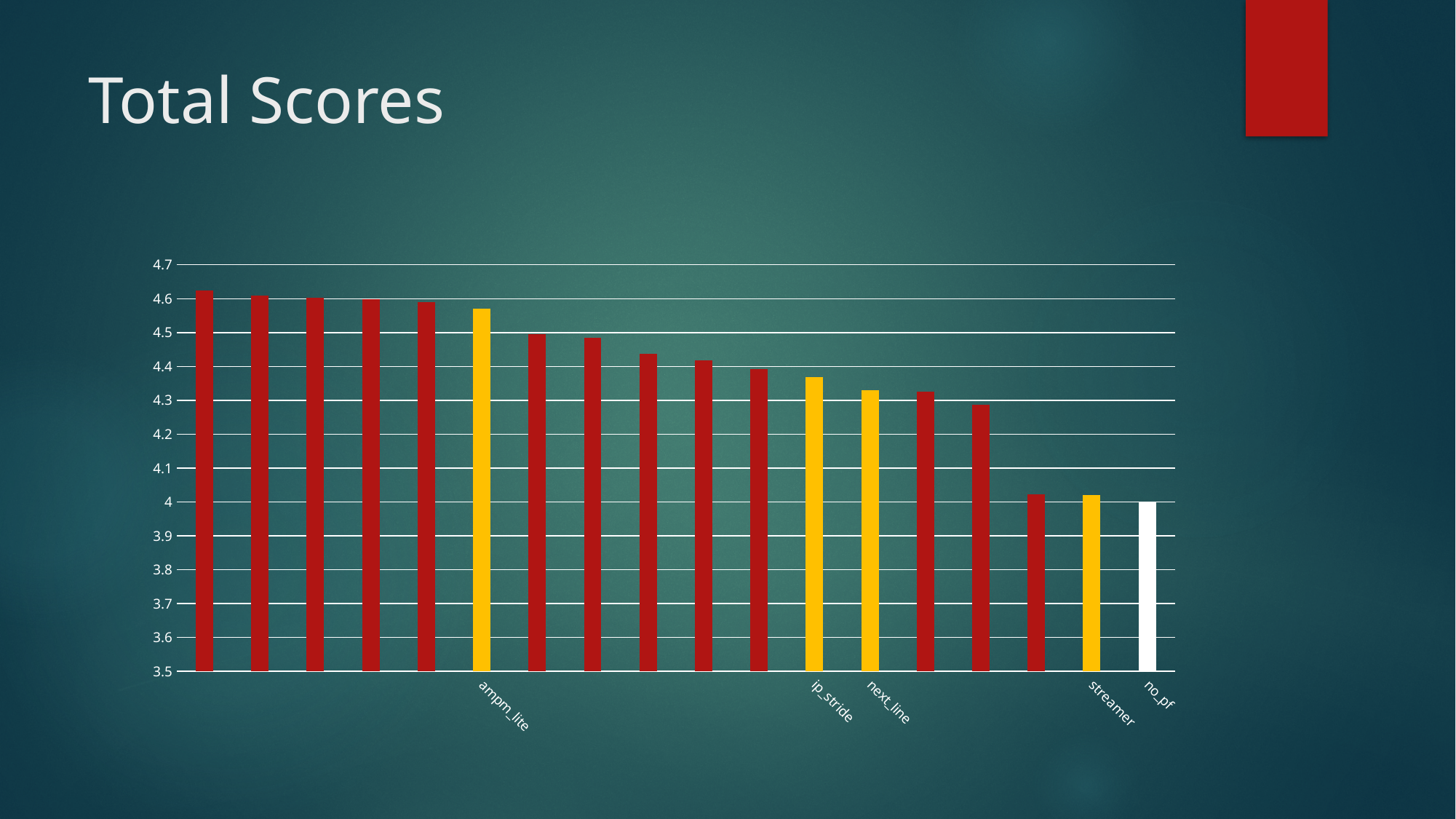
Which has the larger value, ampm_lite or ip_stride? ampm_lite Is the value for streamer greater or less than 4.1? less What kind of chart is shown on the slide? bar chart Is the value for ip_stride greater or less than 4.4? less Is the value for ampm_lite greater or less than 4.5? greater How many bars are plotted in the chart? 18 What is the value for no_pf? 4 Which has the larger value, next_line or streamer? next_line Do the bar values rise or fall from left to right along the x axis? fall What is the title of the chart? Total Scores What colour is the bar for no_pf? white